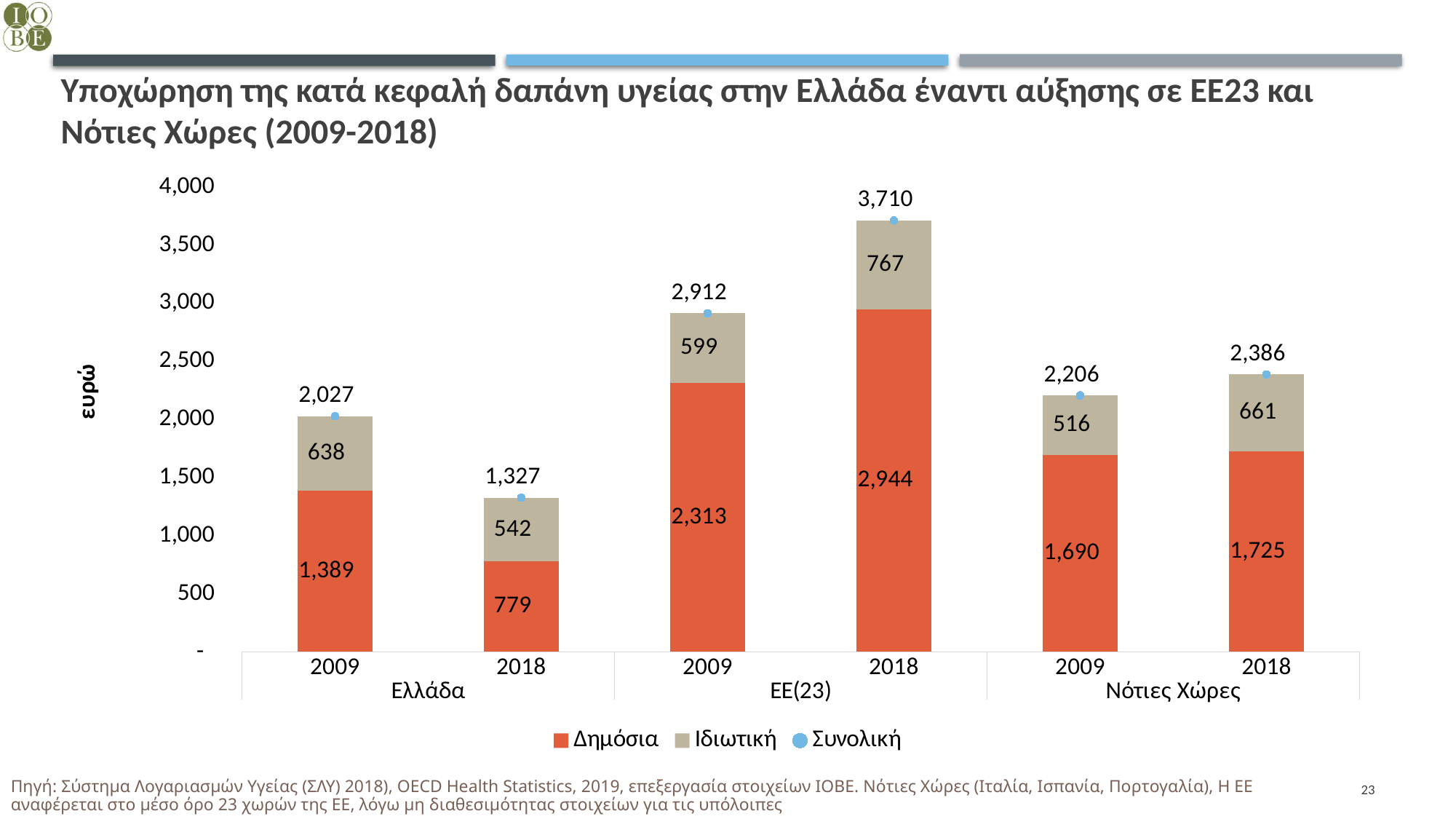
What is the Δημόσια (public) value for Ελλάδα in 2009? 1,389 Which is larger: the Δημόσια value for Νότιες Χώρες in 2009 or in 2018? 2018 What is the Συνολική (total) value for Νότιες Χώρες in 2018? 2,386 How many bars are shown in the chart? 6 What is the label on the vertical axis? ευρώ How many series does the legend list? 3 Is the Συνολική (total) value for ΕΕ(23) in 2009 greater or less than 3,000? less Which bar has the lowest Συνολική (total) value? Ελλάδα 2018 What kind of chart is shown on the slide? Stacked bar chart What is the Ιδιωτική (private) value for ΕΕ(23) in 2018? 767 Which bar has the highest Συνολική (total) value? ΕΕ(23) 2018 What is the difference between the Συνολική (total) value for Ελλάδα in 2009 and in 2018? 700